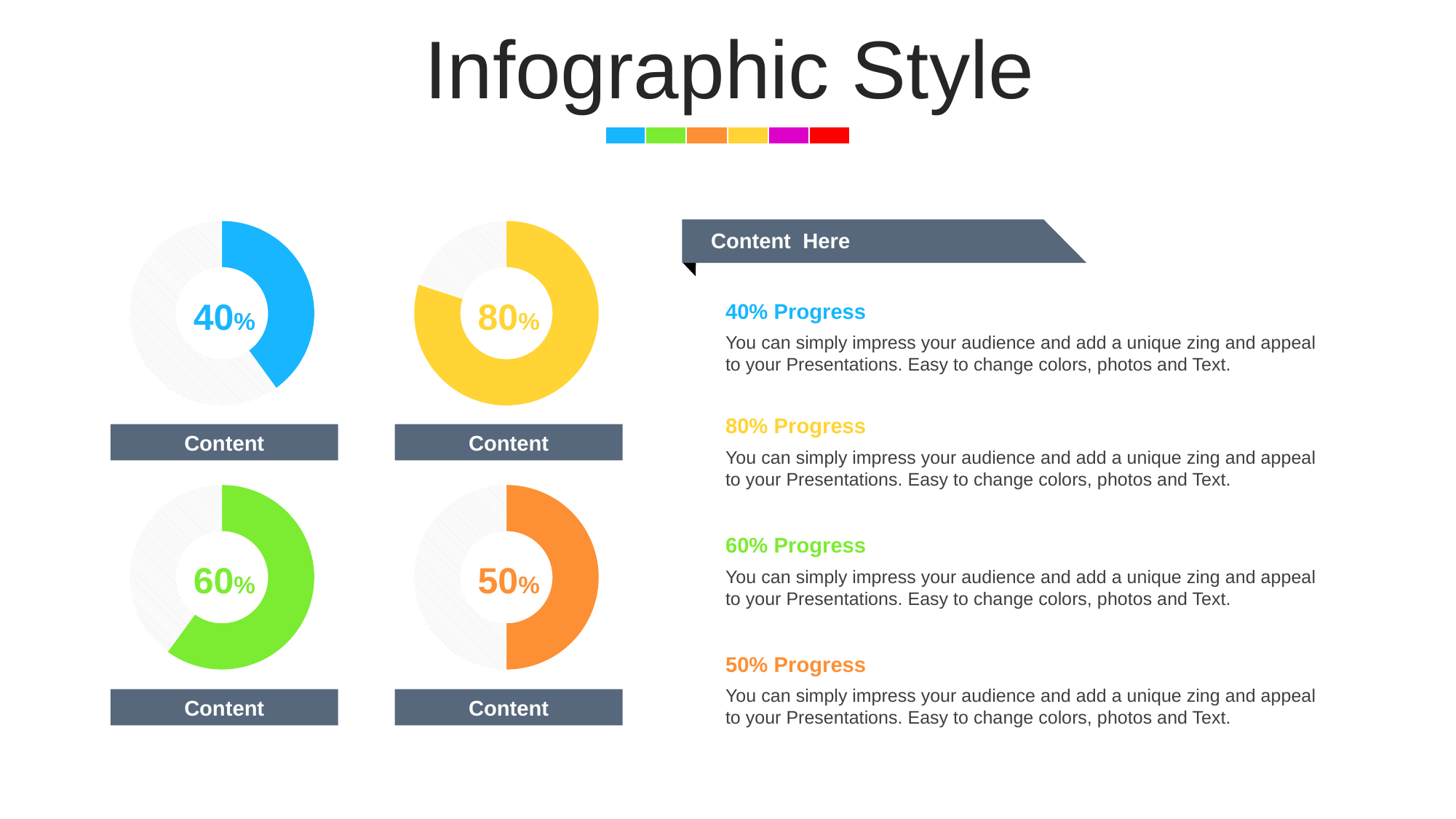
What value is shown in the bottom-left green donut chart? 60% What kind of chart is used to show the progress percentages on the slide? Donut chart What value is shown in the bottom-right orange donut chart? 50% Which is larger: the value in the bottom-left green donut chart or the value in the bottom-right orange donut chart? The bottom-left green chart (60%) What colour is the donut chart that shows 80%? Yellow What value is shown in the top-right yellow donut chart? 80% What value is shown in the top-left blue donut chart? 40% How many donut charts are shown on the slide? 4 Which of the four donut charts shows the highest percentage? The top-right yellow chart (80%) Which of the four donut charts shows the lowest percentage? The top-left blue chart (40%) What is the difference between the value in the bottom-left green donut chart and the value in the bottom-right orange donut chart? 10% What is the difference between the value in the top-right yellow donut chart and the value in the top-left blue donut chart? 40%